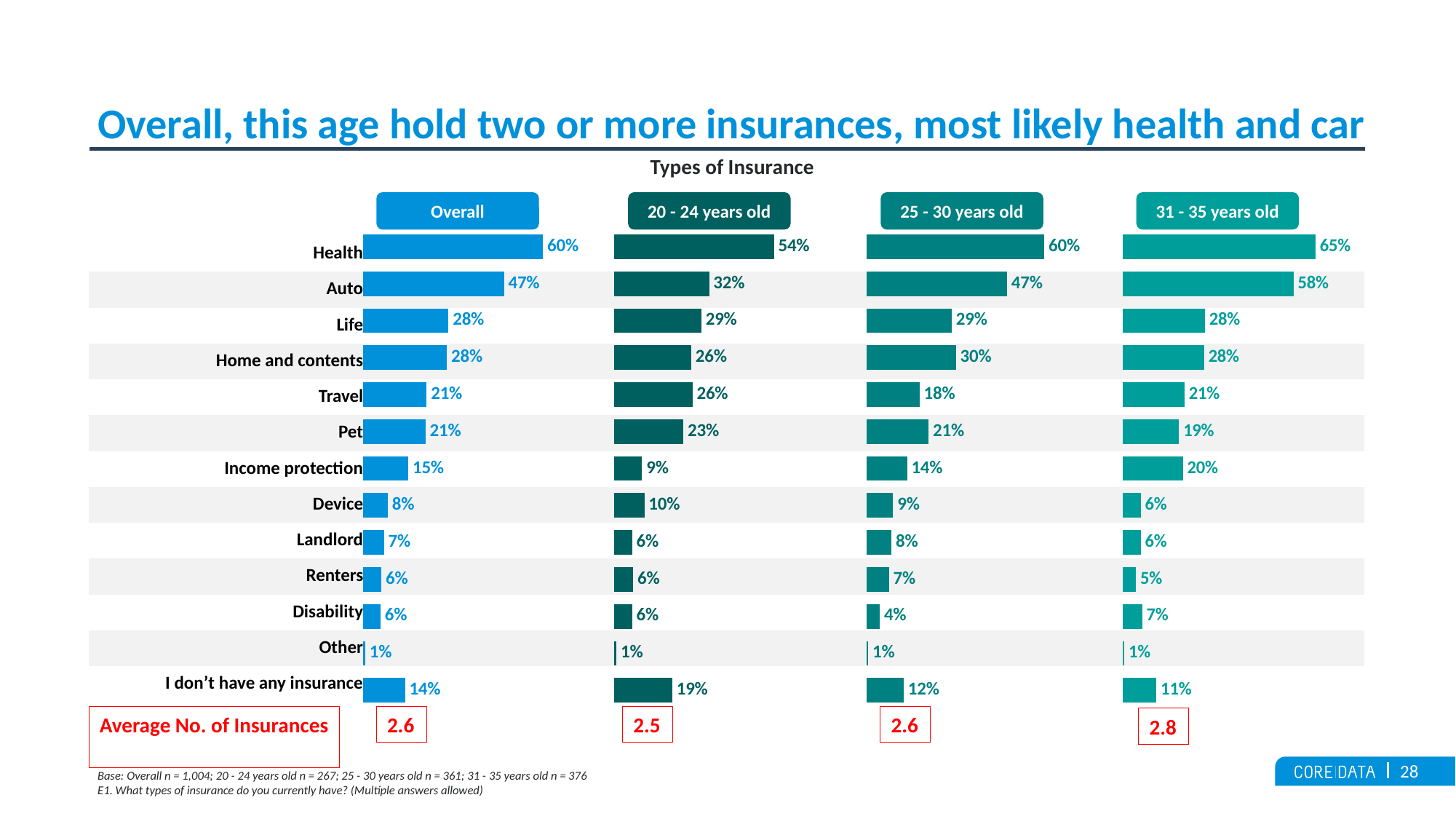
In the 25 - 30 years old chart, what is the value for 'I don't have any insurance'? 12% In the 31 - 35 years old chart, what is the value for Income protection? 20% Which age group has the larger value for Travel insurance: 20 - 24 years old or 25 - 30 years old? 20 - 24 years old How many insurance categories are listed in each chart? 13 In the Overall chart, what is the difference between the Health and Auto values? 13 percentage points What is the difference between the Auto insurance value in the 31 - 35 years old chart and the Auto insurance value in the 20 - 24 years old chart? 26 percentage points In the 31 - 35 years old chart, which type of insurance has the highest value? Health What is the Average No. of Insurances shown for the 31 - 35 years old group? 2.8 In the Overall chart, what percentage of respondents hold Health insurance? 60% In the 25 - 30 years old chart, which category has the lowest value? Other In the 20 - 24 years old chart, what is the value for Auto insurance? 32% What kind of chart is used to show the types of insurance? Bar chart